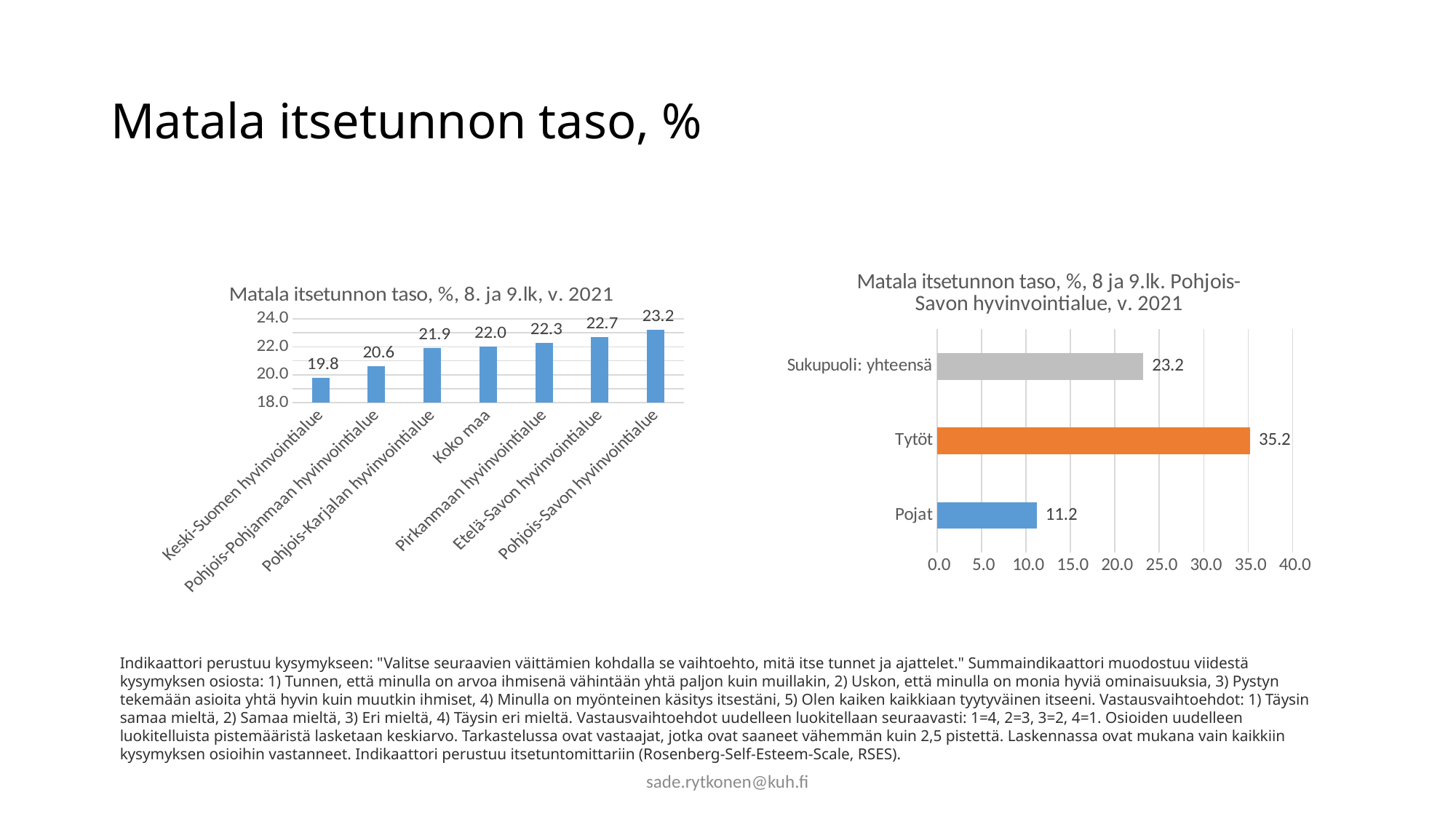
In the right chart (Pohjois-Savon hyvinvointialue, v. 2021), what is the value for Pojat? 11.2 In the left chart (Matala itsetunnon taso, %, 8. ja 9.lk, v. 2021), do the values rise or fall from left to right? rise In the right chart (Pohjois-Savon hyvinvointialue, v. 2021), what is the difference between Tytöt and Pojat? 24.0 What kind of chart is the right chart (Pohjois-Savon hyvinvointialue, v. 2021)? bar chart In the left chart (Matala itsetunnon taso, %, 8. ja 9.lk, v. 2021), what is the value for Koko maa? 22.0 In the right chart (Pohjois-Savon hyvinvointialue, v. 2021), what is the value for Tytöt? 35.2 In the left chart (Matala itsetunnon taso, %, 8. ja 9.lk, v. 2021), how many categories are shown? 7 In the left chart (Matala itsetunnon taso, %, 8. ja 9.lk, v. 2021), what is the difference between Pohjois-Savon hyvinvointialue and Keski-Suomen hyvinvointialue? 3.4 In the left chart (Matala itsetunnon taso, %, 8. ja 9.lk, v. 2021), which category has the lowest value? Keski-Suomen hyvinvointialue In the right chart (Pohjois-Savon hyvinvointialue, v. 2021), which is larger, Tytöt or Sukupuoli: yhteensä? Tytöt In the left chart (Matala itsetunnon taso, %, 8. ja 9.lk, v. 2021), which category has the highest value? Pohjois-Savon hyvinvointialue In the left chart (Matala itsetunnon taso, %, 8. ja 9.lk, v. 2021), what is the value for Pirkanmaan hyvinvointialue? 22.3